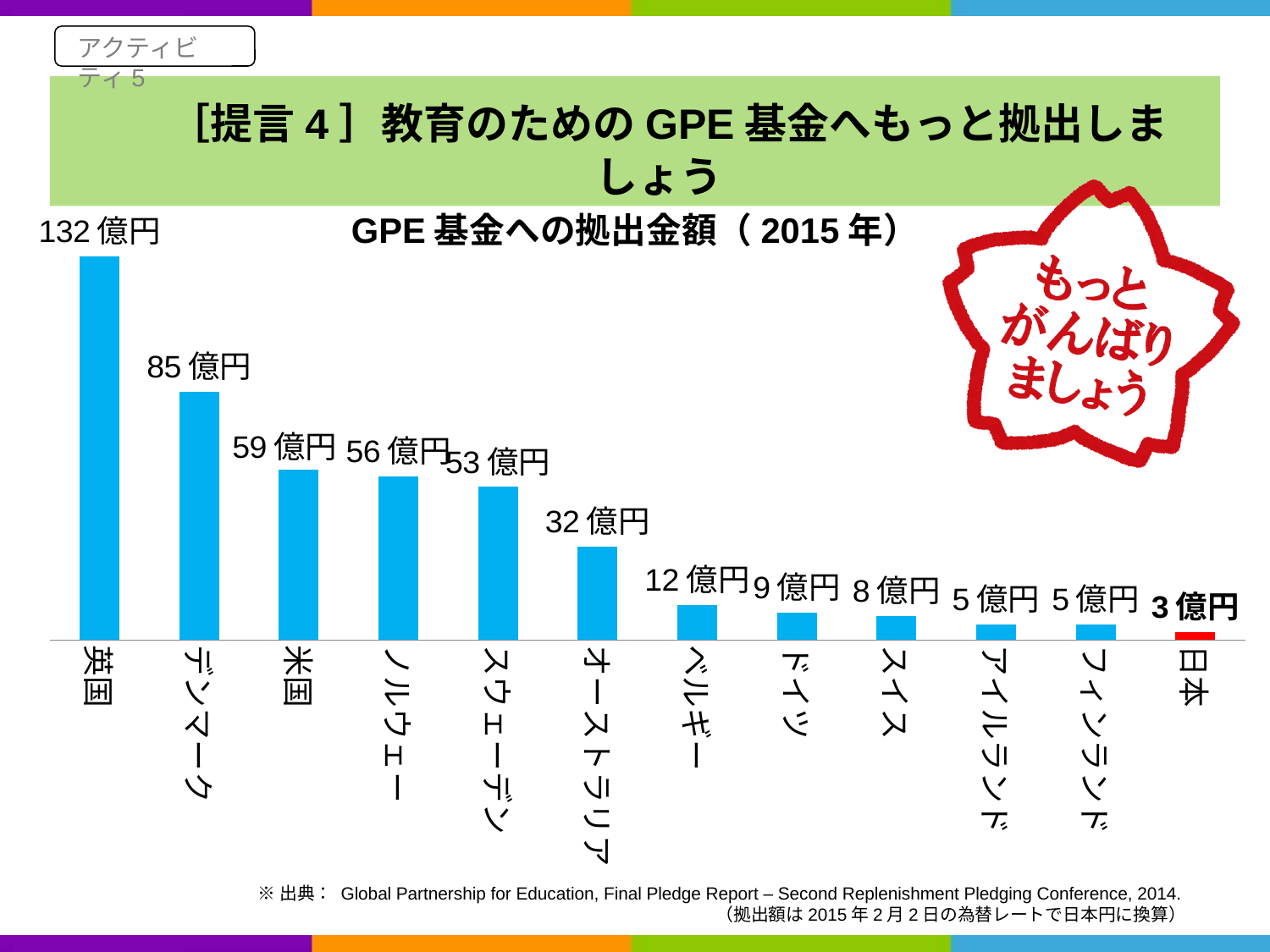
What type of chart is shown on the slide? bar chart What is the difference between the values for デンマーク and 米国? 26 億円 What is the value for デンマーク in the chart? 85 億円 Which country has the highest value in the chart? 英国 What is the difference between the values for 英国 and 日本? 129 億円 What is the value for 英国 in the chart? 132 億円 What is the value for オーストラリア in the chart? 32 億円 How many countries are shown in the chart? 12 What is the value for 日本 in the chart? 3 億円 Which country has the lowest value in the chart? 日本 Which is larger, the value for ノルウェー or the value for ベルギー? ノルウェー Do the values rise or fall from left to right across the chart? fall